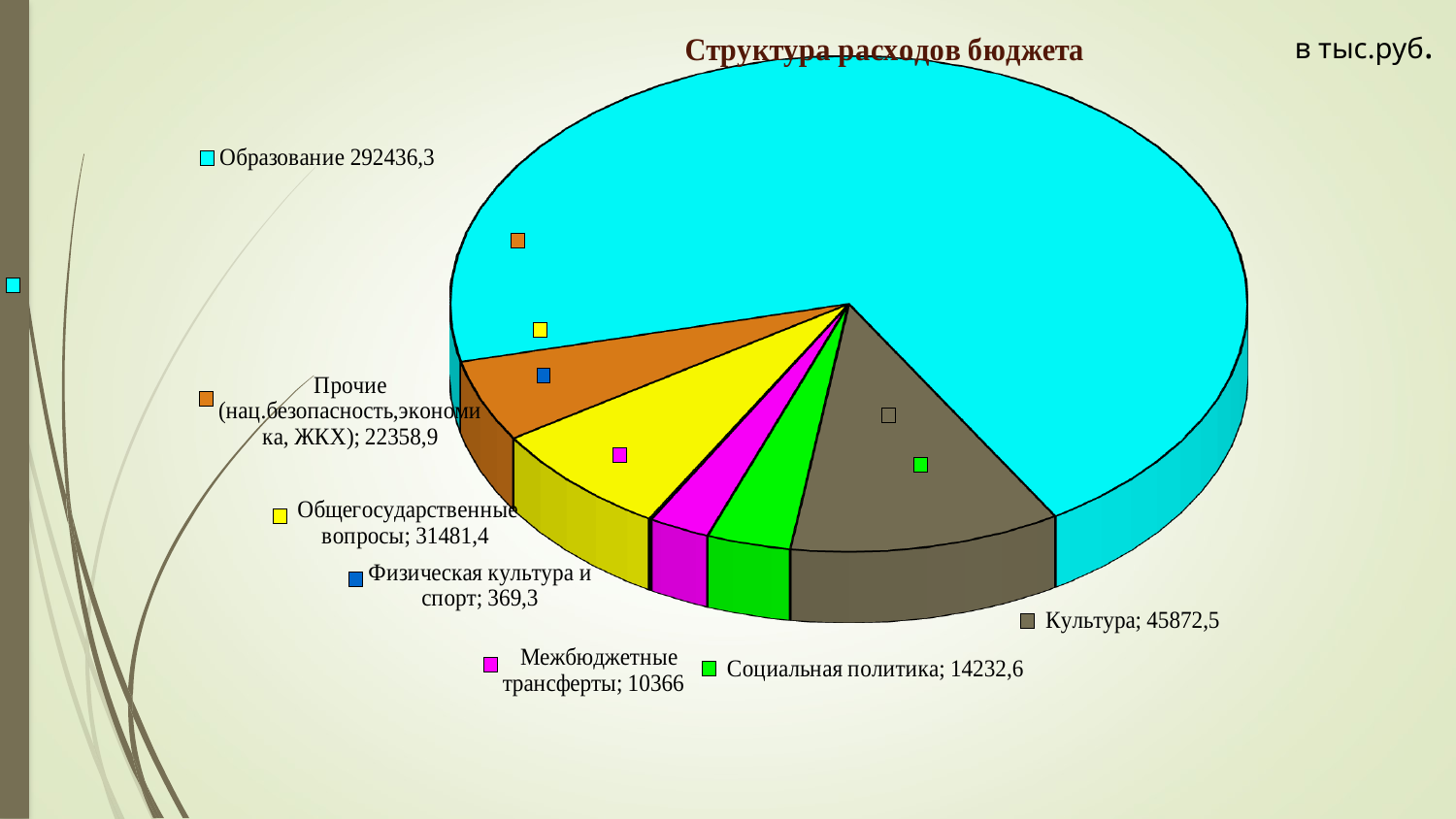
What is the value for Физическая культура и спорт? 369,3 What is the value for Образование? 292436,3 What is the value for Культура? 45872,5 Which category has the largest value? Образование Which category has the smallest value? Физическая культура и спорт What is the title of the chart? Структура расходов бюджета How many categories does the pie chart have? 7 What is the difference between the values for Культура and Общегосударственные вопросы? 14391,1 In what units are the values on the chart given? тыс.руб. What is the value for Межбюджетные трансферты? 10366 What type of chart is shown on the slide? pie chart Which is larger, Общегосударственные вопросы or Социальная политика? Общегосударственные вопросы